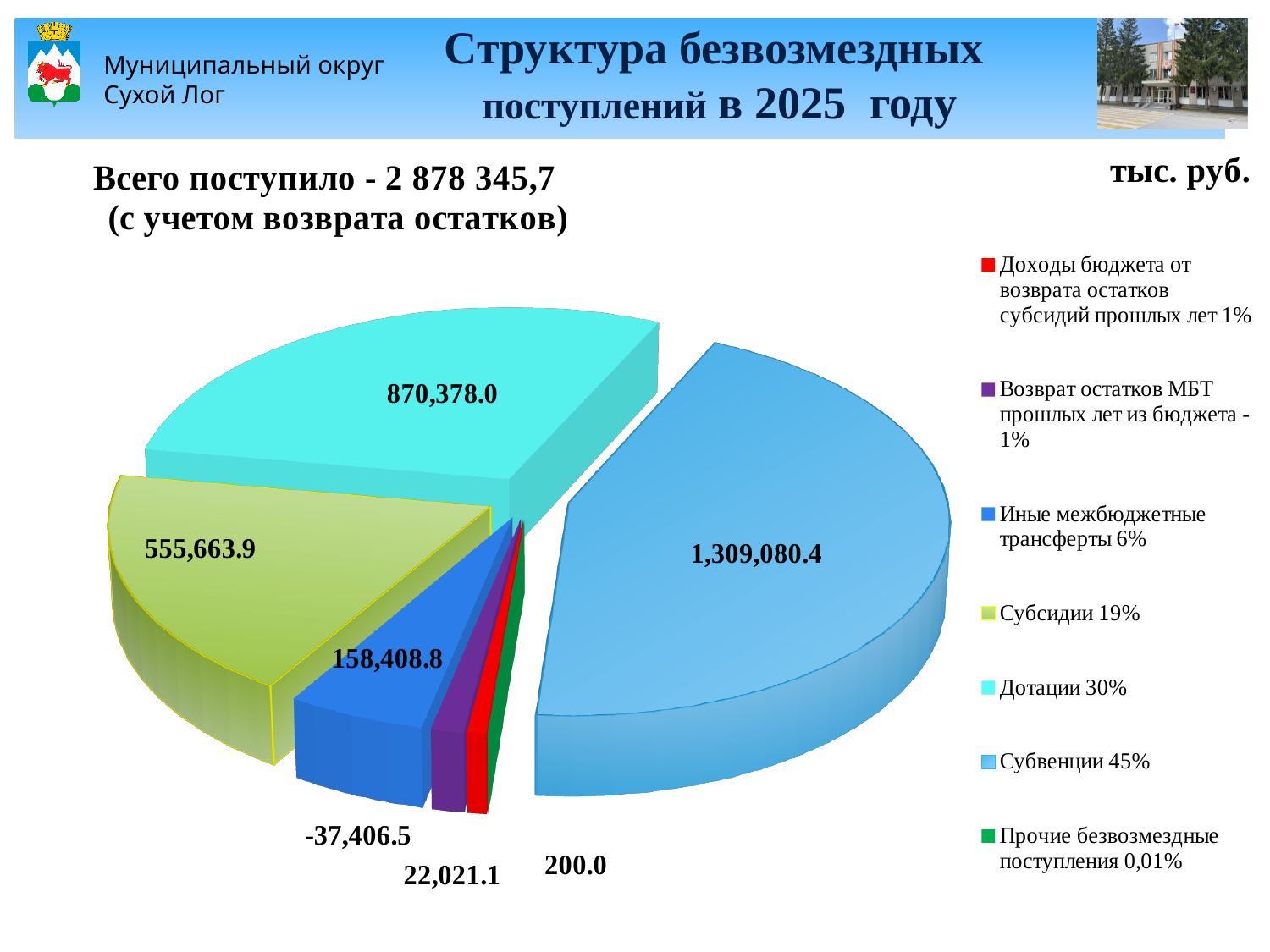
What is the difference between the values for Субвенции and Дотации? 438,702.4 Which category has the largest slice of the pie? Субвенции What is the title of the chart? Всего поступило - 2 878 345,7 (с учетом возврата остатков) How many categories does the legend list? 7 What is the value for Иные межбюджетные трансферты? 158,408.8 What is the value for Субсидии? 555,663.9 Which is larger, the value for Субсидии or the value for Иные межбюджетные трансферты? Субсидии What is the value for Прочие безвозмездные поступления? 200.0 What is the value for Субвенции? 1,309,080.4 What is the value for Дотации? 870,378.0 What share of the pie does Дотации represent according to the legend? 30% What kind of chart is shown on the slide? pie chart